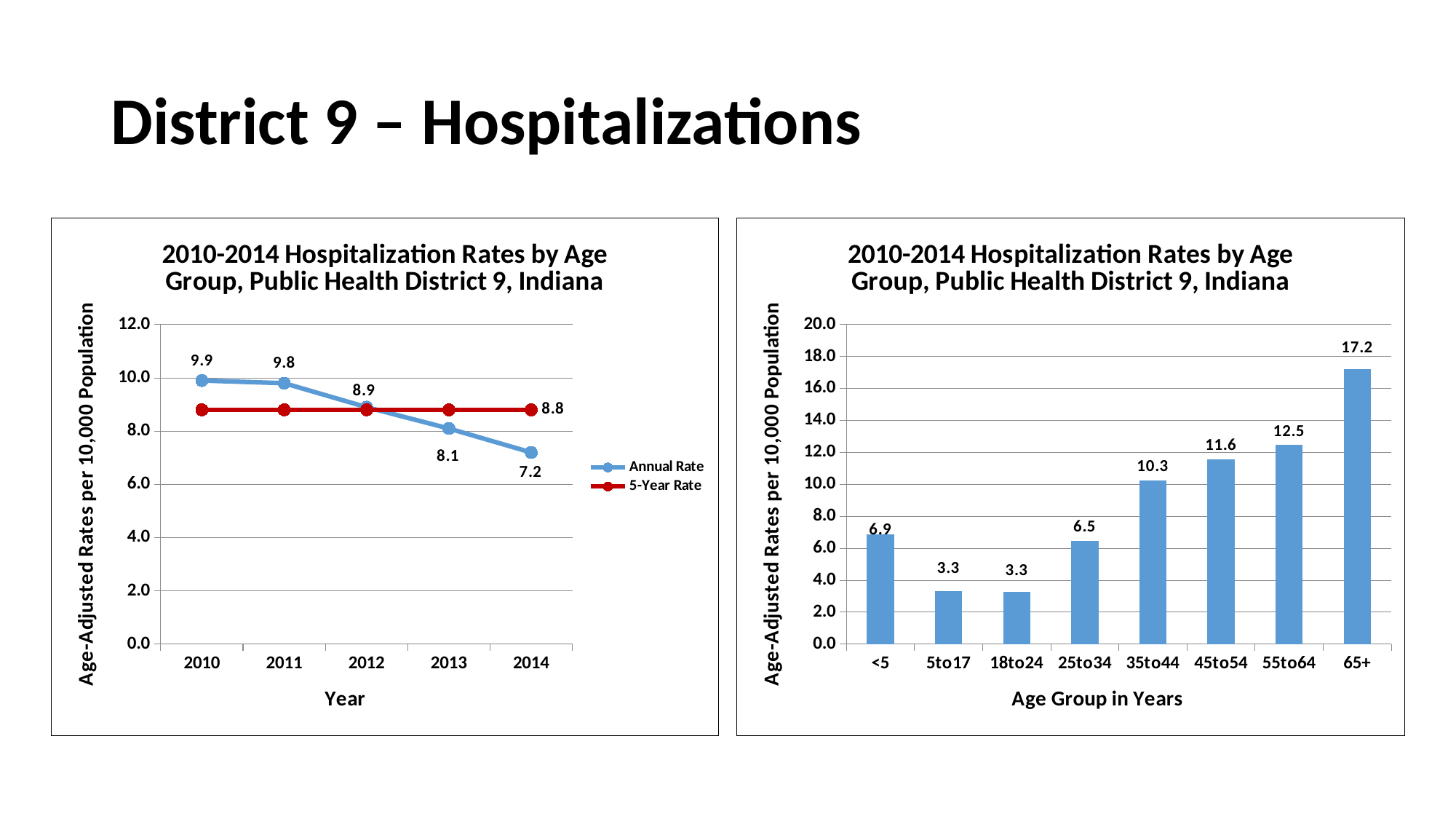
In the left chart, what is the 5-Year Rate? 8.8 In the right chart, which is larger, the rate for <5 or the rate for 25to34? <5 In the left chart, what is the difference between the Annual Rate in 2010 and in 2014? 2.7 How many series does the legend of the left chart list? 2 In the right chart, which age group has the highest hospitalization rate? 65+ What kind of chart is the right chart? bar chart In the left chart, does the Annual Rate rise or fall from 2010 to 2014? fall In the left chart, what is the Annual Rate for 2010? 9.9 In the right chart, how many age groups are shown? 8 In the left chart, what is the Annual Rate for 2014? 7.2 In the right chart, what is the hospitalization rate for the 65+ age group? 17.2 In the left chart, which year has the lowest Annual Rate? 2014